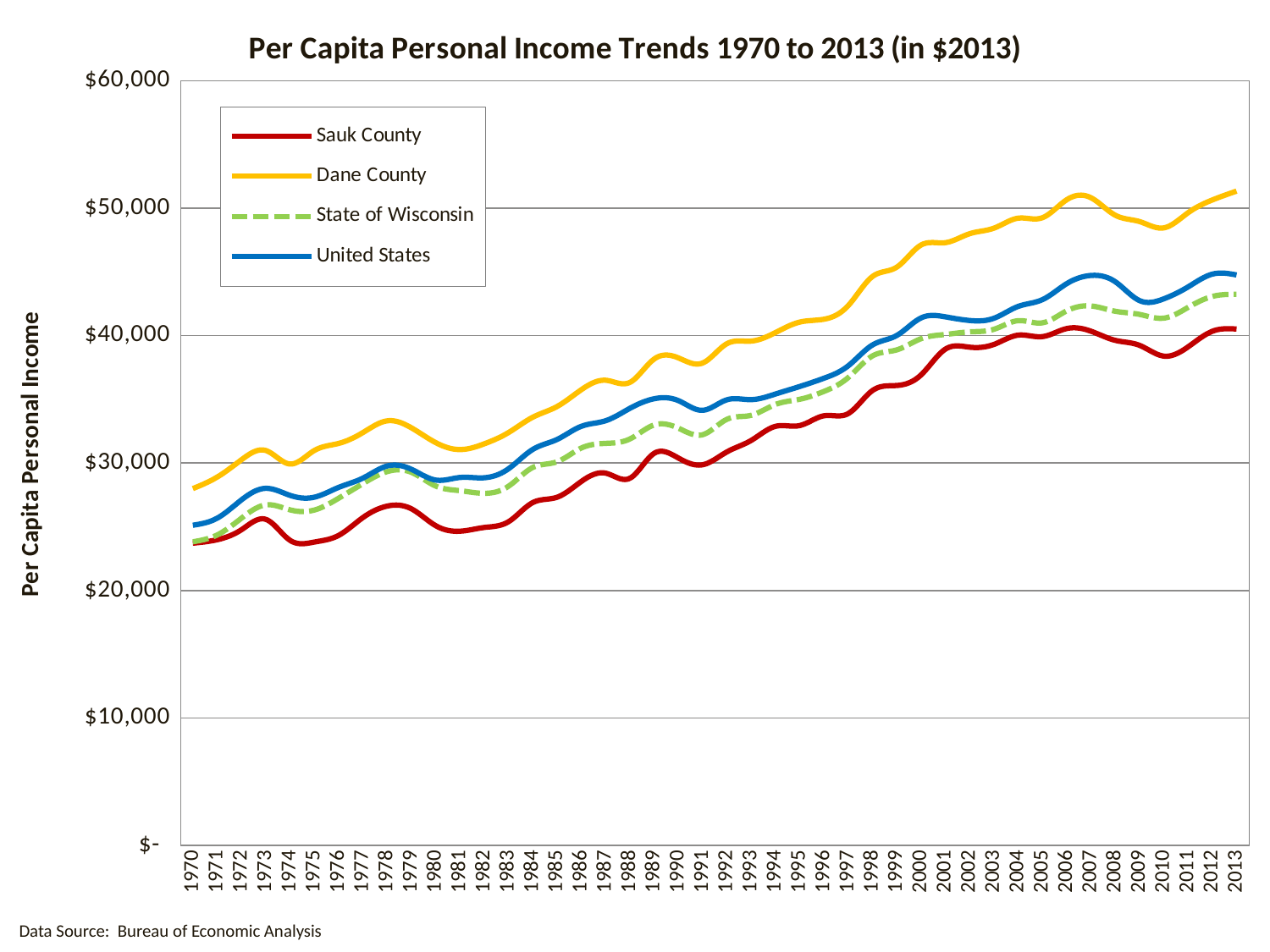
Is the value for Sauk County in 1970 greater or less than $30,000? less Which series has the highest per capita personal income in 2013? Dane County Is the value for United States in 2007 greater or less than $40,000? greater How many series does the legend list? 4 Is the value for Dane County in 2013 greater or less than $50,000? greater In 2013, which is larger: the value for Dane County or the value for Sauk County? Dane County What kind of chart is shown on the slide? Line chart Does the Dane County line generally rise or fall from 1970 to 2013? Rise Which series has the lowest per capita personal income in 2013? Sauk County Which series has the highest per capita personal income in 1970? Dane County Which series is drawn with a dashed line? State of Wisconsin How many years are plotted along the x axis? 44